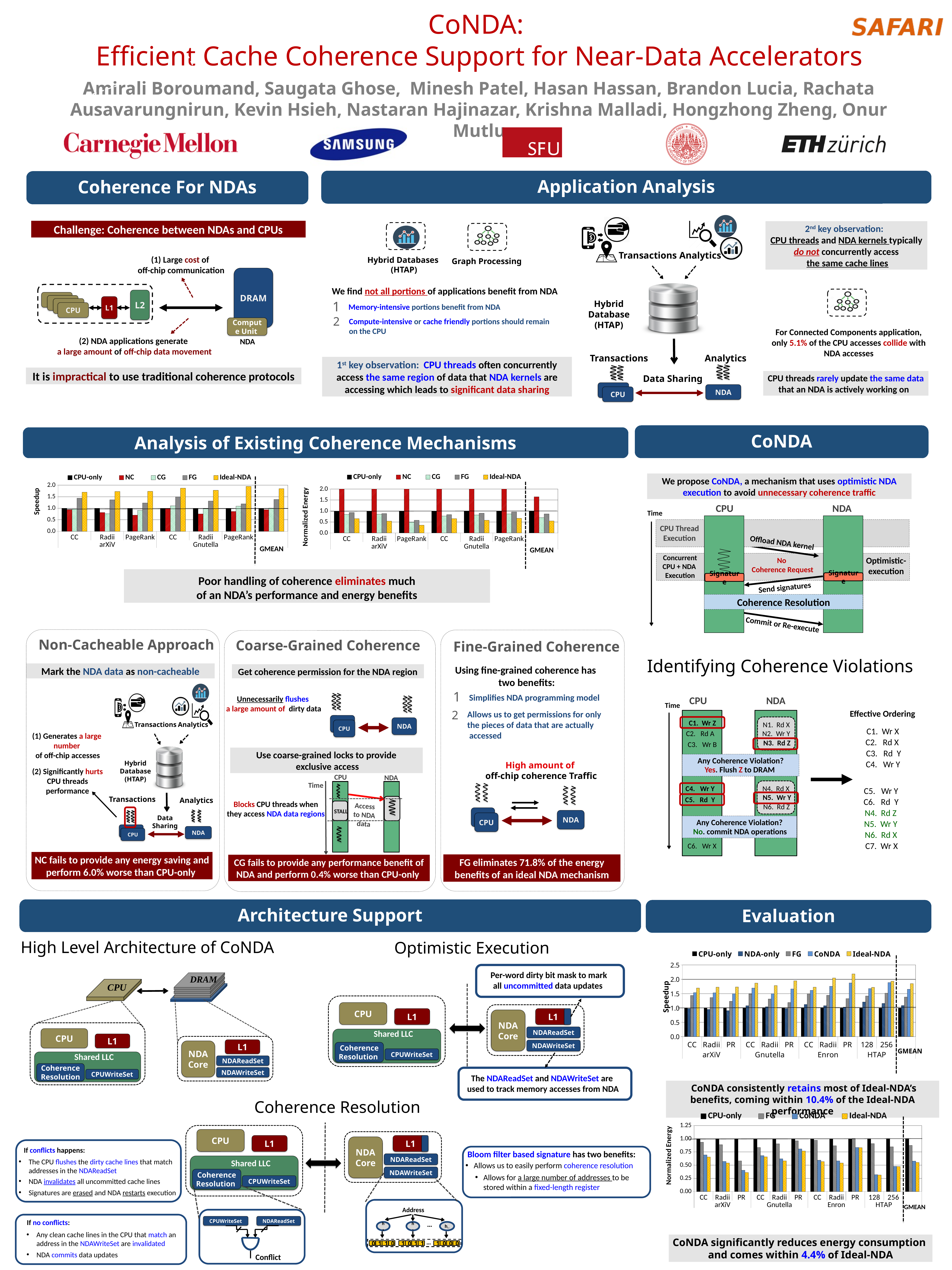
In the Normalized Energy chart in the Evaluation section, is the Ideal-NDA value for 128 (HTAP) greater or less than 0.5? less In the Normalized Energy chart under 'Analysis of Existing Coherence Mechanisms', is the NC value for CC (arXiV) greater or less than 1.5? greater In the Speedup chart under 'Analysis of Existing Coherence Mechanisms', which series has the highest bar for PageRank (Gnutella)? Ideal-NDA In the Speedup chart in the Evaluation section, how many series does the legend list? 5 In the Speedup chart in the Evaluation section, which is larger for GMEAN: CoNDA or CPU-only? CoNDA In the Normalized Energy chart under 'Analysis of Existing Coherence Mechanisms', which is larger for GMEAN: NC or CG? NC In the Normalized Energy chart in the Evaluation section, how many series does the legend list? 4 In the Speedup chart under 'Analysis of Existing Coherence Mechanisms', is the Ideal-NDA value for CC (arXiV) greater or less than 1.5? greater What kind of chart is the Speedup chart under 'Analysis of Existing Coherence Mechanisms'? bar chart In the Speedup chart under 'Analysis of Existing Coherence Mechanisms', how many series does the legend list? 5 In the Normalized Energy chart under 'Analysis of Existing Coherence Mechanisms', which series has the lowest bar for CC (arXiV)? Ideal-NDA